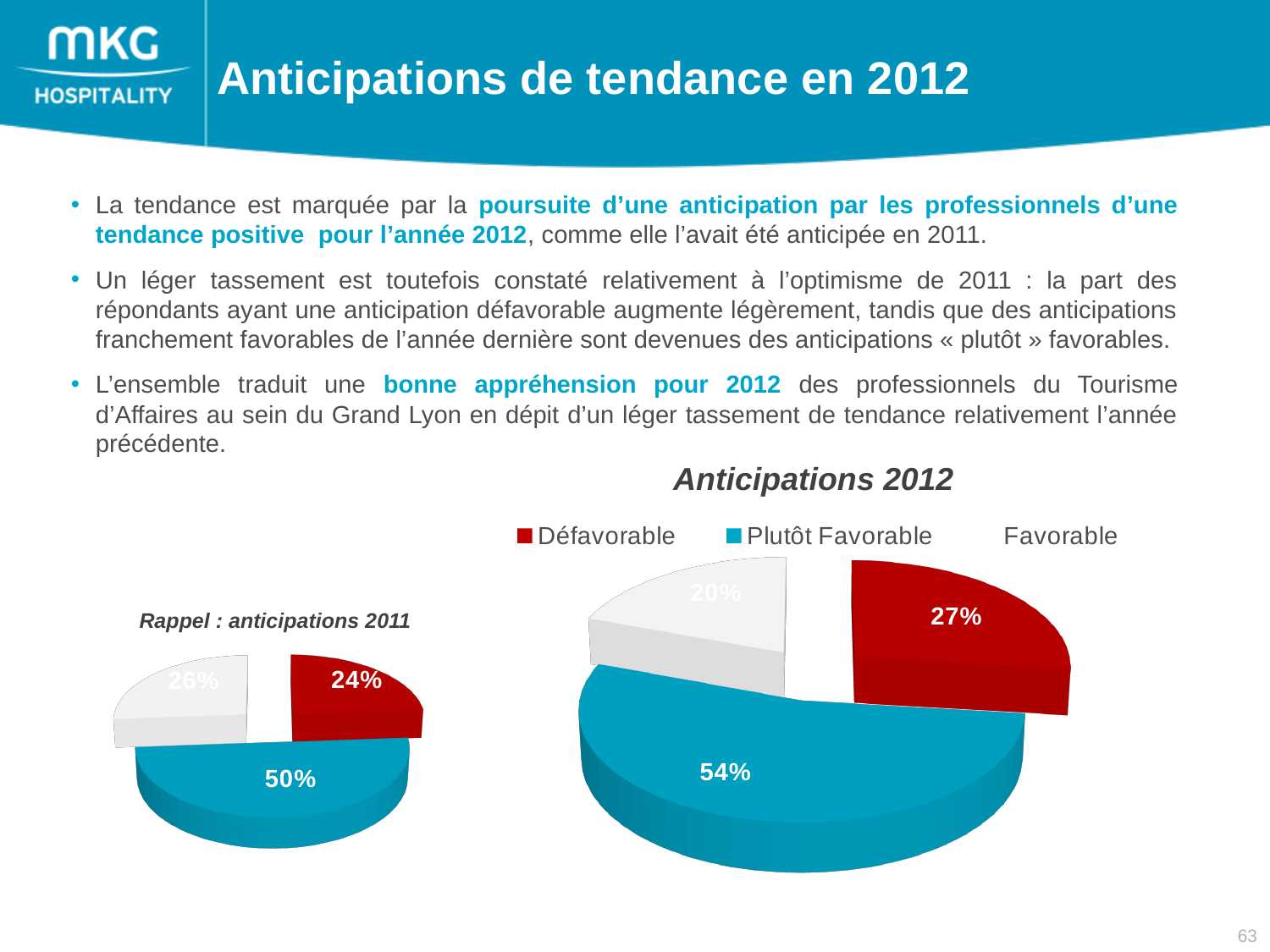
In the 'Rappel : anticipations 2011' chart, what is the value of the blue 'Plutôt Favorable' slice? 50% In the 'Anticipations 2012' chart, which category has the largest share? Plutôt Favorable What is the difference between the 'Plutôt Favorable' share in the 'Anticipations 2012' chart and the 'Plutôt Favorable' share in the 'Rappel : anticipations 2011' chart? 4 percentage points In the 'Rappel : anticipations 2011' chart, what is the value of the red 'Défavorable' slice? 24% In the 'Anticipations 2012' chart, what colour is the 'Défavorable' slice? Red In the 'Anticipations 2012' chart, which category has the smallest share? Favorable In the 'Anticipations 2012' chart, what share of respondents have a 'Plutôt Favorable' anticipation? 54% What type of chart is 'Anticipations 2012'? Pie chart In the 'Anticipations 2012' chart, what is the value for 'Favorable'? 20% How many categories does the legend of the 'Anticipations 2012' chart list? 3 In the 'Anticipations 2012' chart, what is the value for 'Défavorable'? 27% Which is larger: the 'Défavorable' share in the 'Anticipations 2012' chart or the 'Défavorable' share in the 'Rappel : anticipations 2011' chart? Anticipations 2012